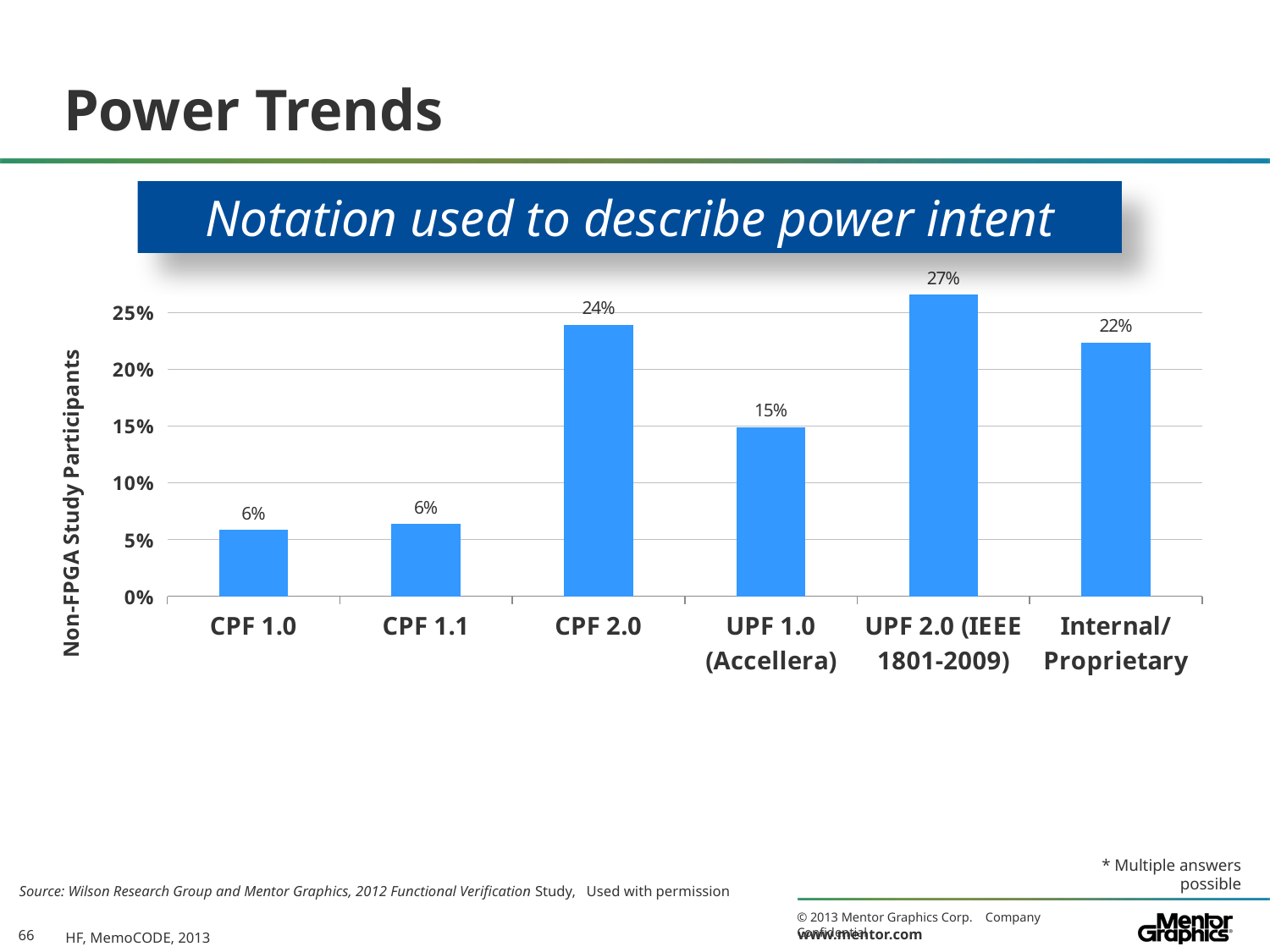
What is the value shown for Internal/Proprietary notation? 22% What is the label of the vertical axis? Non-FPGA Study Participants Which is larger, the value for UPF 1.0 (Accellera) or the value for Internal/Proprietary? Internal/Proprietary What is the title of the chart? Notation used to describe power intent What is the difference between the values for CPF 2.0 and CPF 1.0? 18% Is the value for UPF 2.0 (IEEE 1801-2009) greater or less than 25%? greater How many notation categories are shown on the x axis? 6 What is the value shown for UPF 1.0 (Accellera)? 15% What is the difference between the values for UPF 2.0 (IEEE 1801-2009) and CPF 2.0? 3% What kind of chart is shown on the slide? bar chart Which notation has the highest percentage of non-FPGA study participants? UPF 2.0 (IEEE 1801-2009) What percentage of non-FPGA study participants use CPF 2.0? 24%